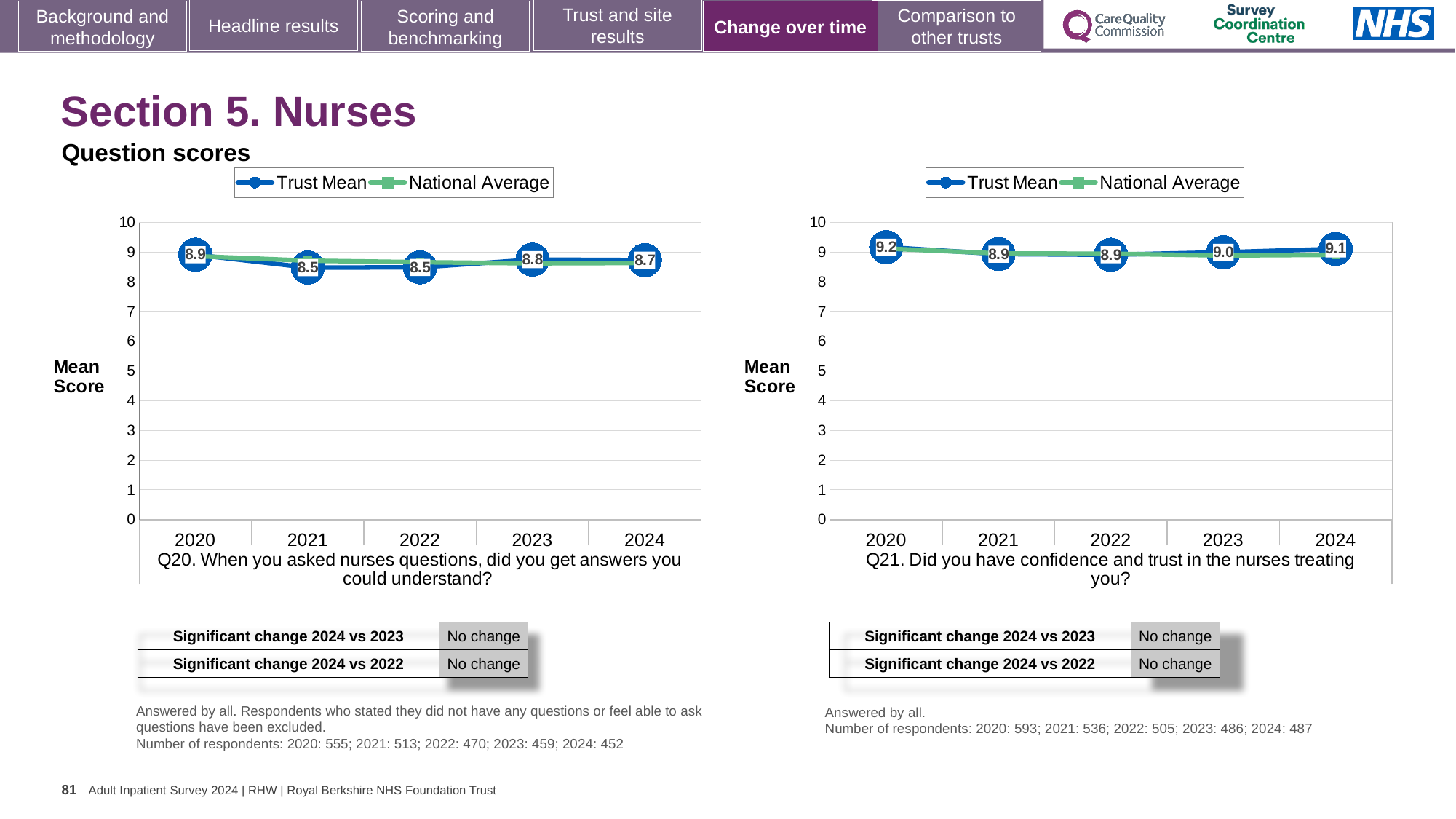
In the left chart (Q20), what is the difference between the Trust Mean scores for 2020 and 2021? 0.4 In the right chart (Q21), which year has the highest Trust Mean score? 2020 How many years are shown on the x axis of the left chart (Q20)? 5 What kind of chart is the left chart (Q20)? line chart In the right chart (Q21), does the Trust Mean score rise or fall from 2022 to 2024? rise In the left chart (Q20), what is the Trust Mean score for 2024? 8.7 How many series does the legend of the right chart (Q21) list? 2 In the left chart (Q20), what is the Trust Mean score for 2020? 8.9 In the right chart (Q21), is the Trust Mean score for 2020 greater or less than 9? greater In the right chart (Q21), what is the Trust Mean score for 2022? 8.9 In the right chart (Q21), what is the difference between the Trust Mean scores for 2024 and 2023? 0.1 In the left chart (Q20), is the Trust Mean score for 2023 higher or lower than for 2022? higher